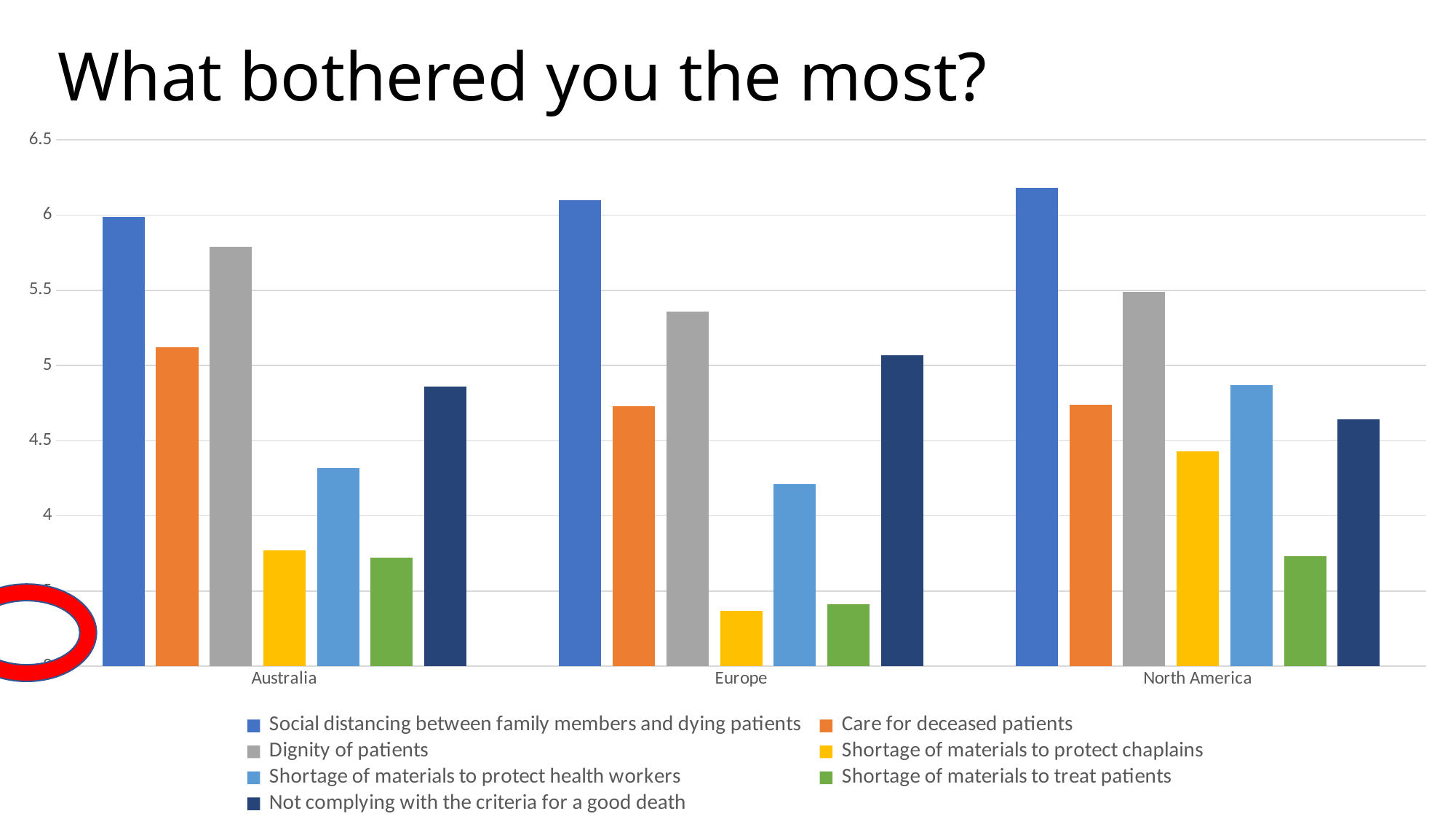
Is the value for Shortage of materials to protect health workers in North America greater or less than 5? less Is the value for Social distancing between family members and dying patients in Australia greater or less than 5.5? greater Which region has the highest value for Dignity of patients? Australia Which is larger in Australia: Dignity of patients or Care for deceased patients? Dignity of patients Which series has the lowest value for North America? Shortage of materials to treat patients How many series does the legend list? 7 Is the value for Shortage of materials to protect chaplains in Europe greater or less than 4? less Which is larger for Not complying with the criteria for a good death: Europe or North America? Europe How many regions (categories) are shown on the x axis? 3 What is the title of the chart? What bothered you the most? Which series has the highest value for Europe? Social distancing between family members and dying patients What kind of chart is shown on the slide? bar chart